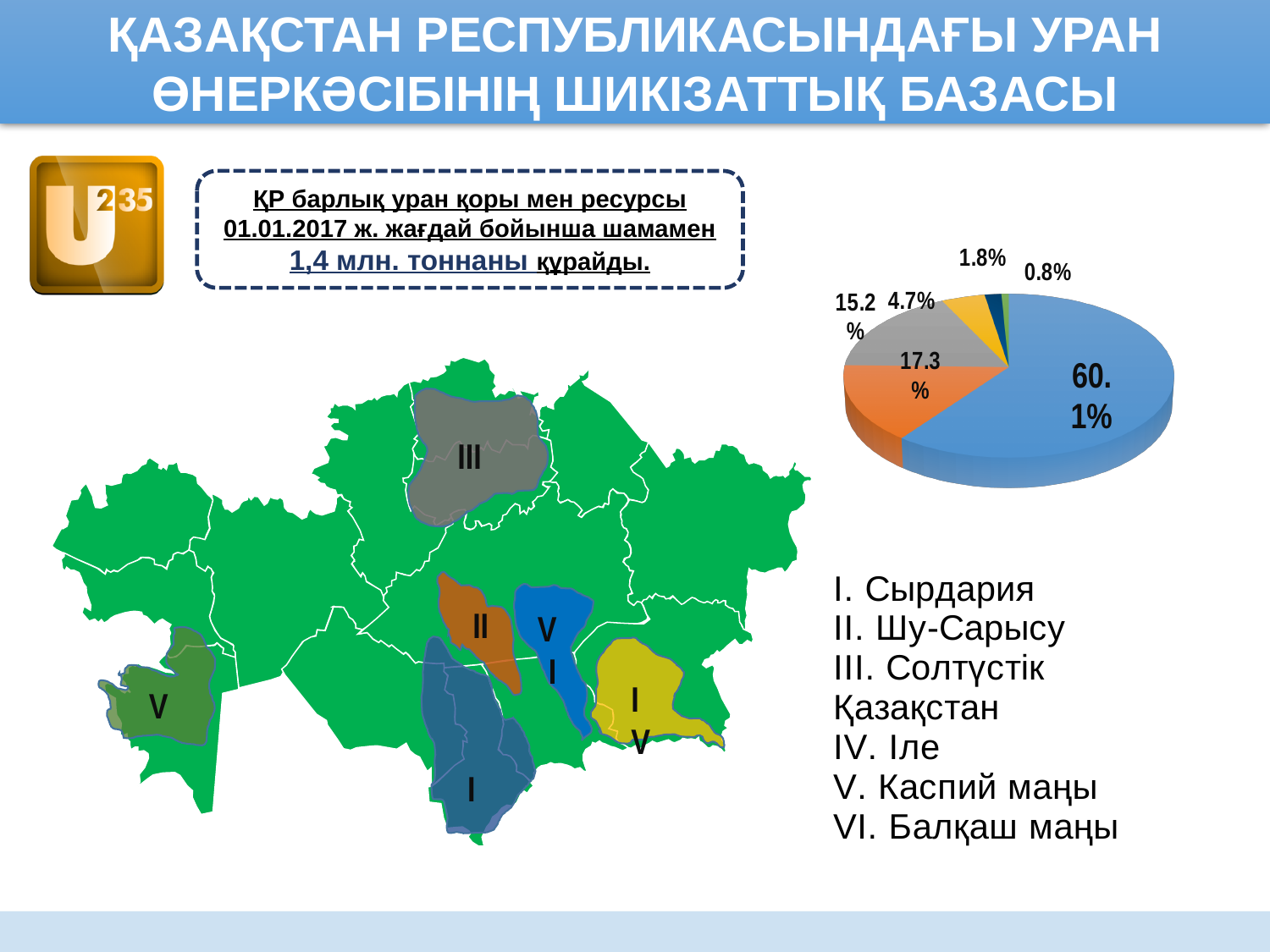
What value is labelled on the orange slice of the pie chart? 17.3% Does the pie chart include a legend identifying its slices? No What is the difference between the 17.3% slice and the 15.2% slice in the pie chart? 2.1% What is the value of the largest slice in the pie chart? 60.1% In the pie chart, which is larger: the yellow slice or the dark blue slice? the yellow slice (4.7%) What kind of chart is shown on the right side of the slide? pie chart How many slices does the pie chart have? 6 What is the difference between the largest slice (60.1%) and the second-largest slice (17.3%) in the pie chart? 42.8% What is the value of the smallest slice in the pie chart? 0.8% What value is labelled on the gray slice of the pie chart? 15.2% What is the value of the second-largest slice in the pie chart? 17.3% Is the largest slice of the pie chart greater or less than 50%? greater